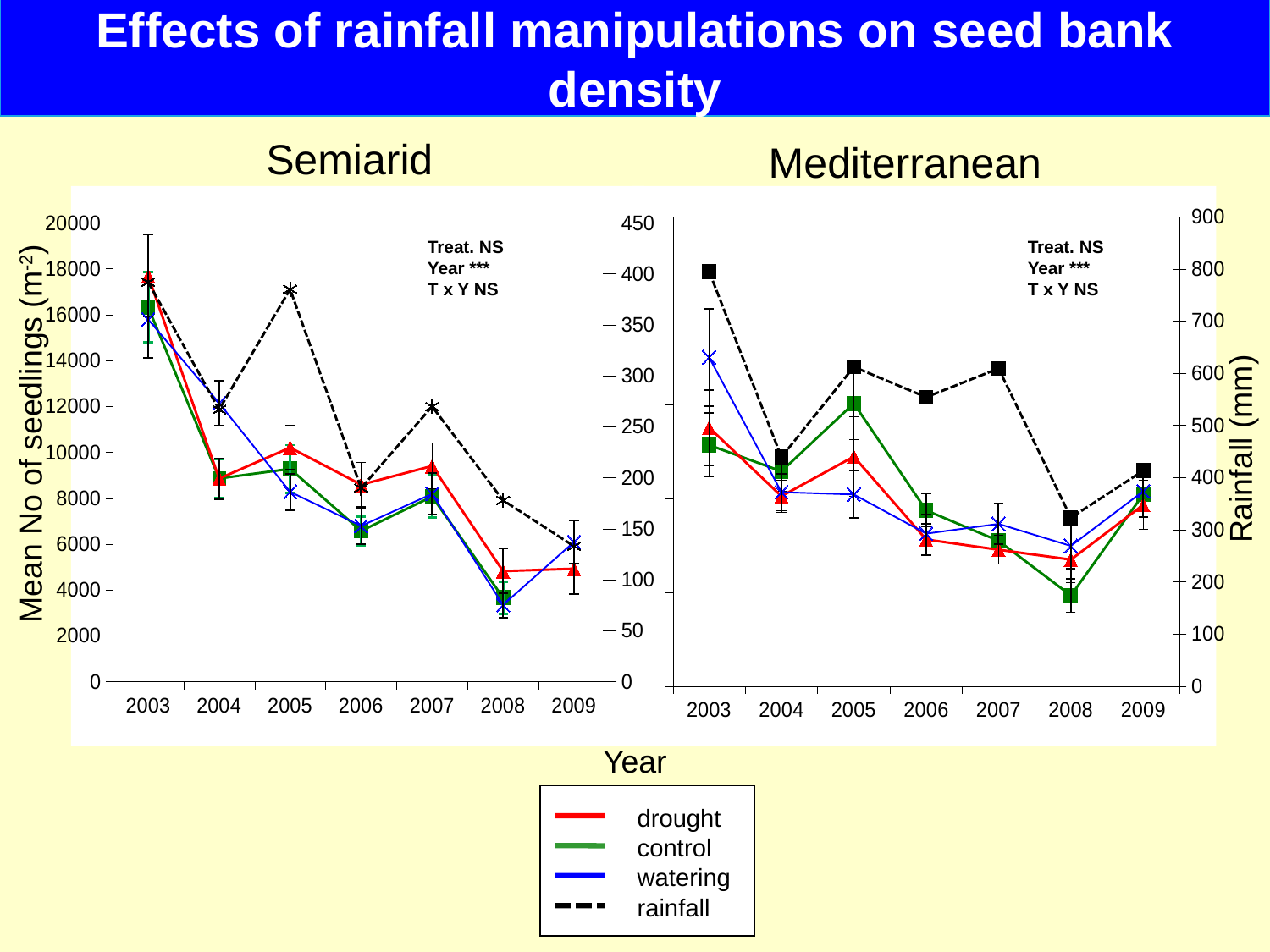
In the Semiarid chart, do the seedling values for the control series generally rise or fall from 2003 to 2009? fall In the Mediterranean chart, which year has the lowest rainfall? 2008 What is the label of the right-hand y axis on the Mediterranean chart? Rainfall (mm) In the Mediterranean chart, which is larger in 2003, the watering value or the drought value? watering How many years are plotted on the x axis of the Mediterranean chart? 7 In the Mediterranean chart, is the rainfall for 2003 greater or less than 700? greater In the Semiarid chart, which year has the lowest rainfall? 2009 In the Semiarid chart, is the control value for 2008 greater or less than 6000? less In the Mediterranean chart, which year has the highest rainfall? 2003 How many series does the legend list? 4 What kind of chart is the Semiarid chart? line chart